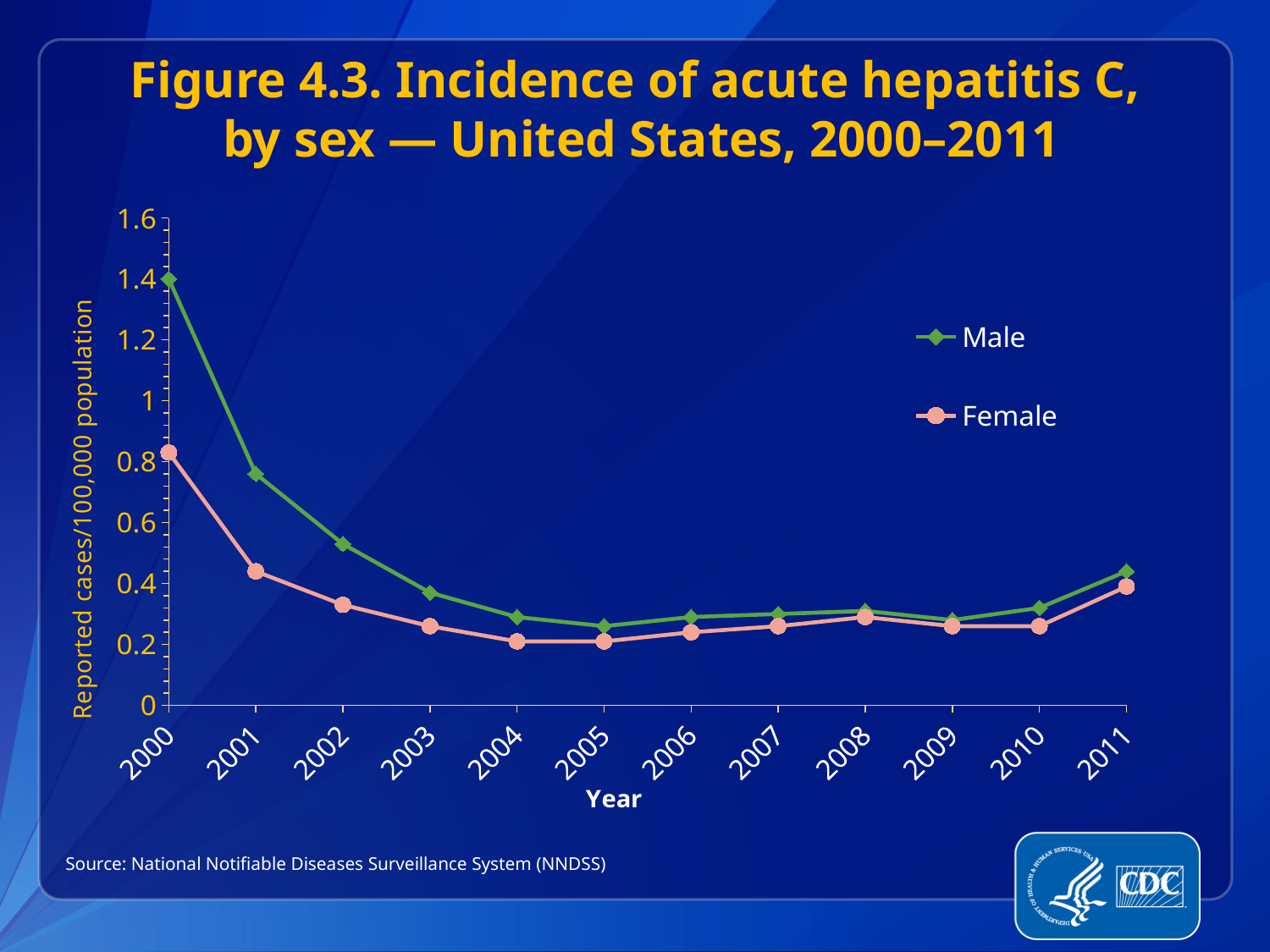
Which year has the highest Male incidence? 2000 In 2000, which series has the larger value, Male or Female? Male How many years are plotted along the x axis? 12 Is the Male value for 2011 greater or less than 0.4? greater Is the Male value for 2002 greater or less than 0.6? less What is the Male incidence in 2000? 1.4 Is the Male value for 2001 greater or less than 0.8? less What is the label of the y axis? Reported cases/100,000 population What kind of chart is shown on the slide? line chart How many series does the legend list? 2 Does the Male incidence rise or fall from 2000 to 2005? fall Which series is drawn in green? Male